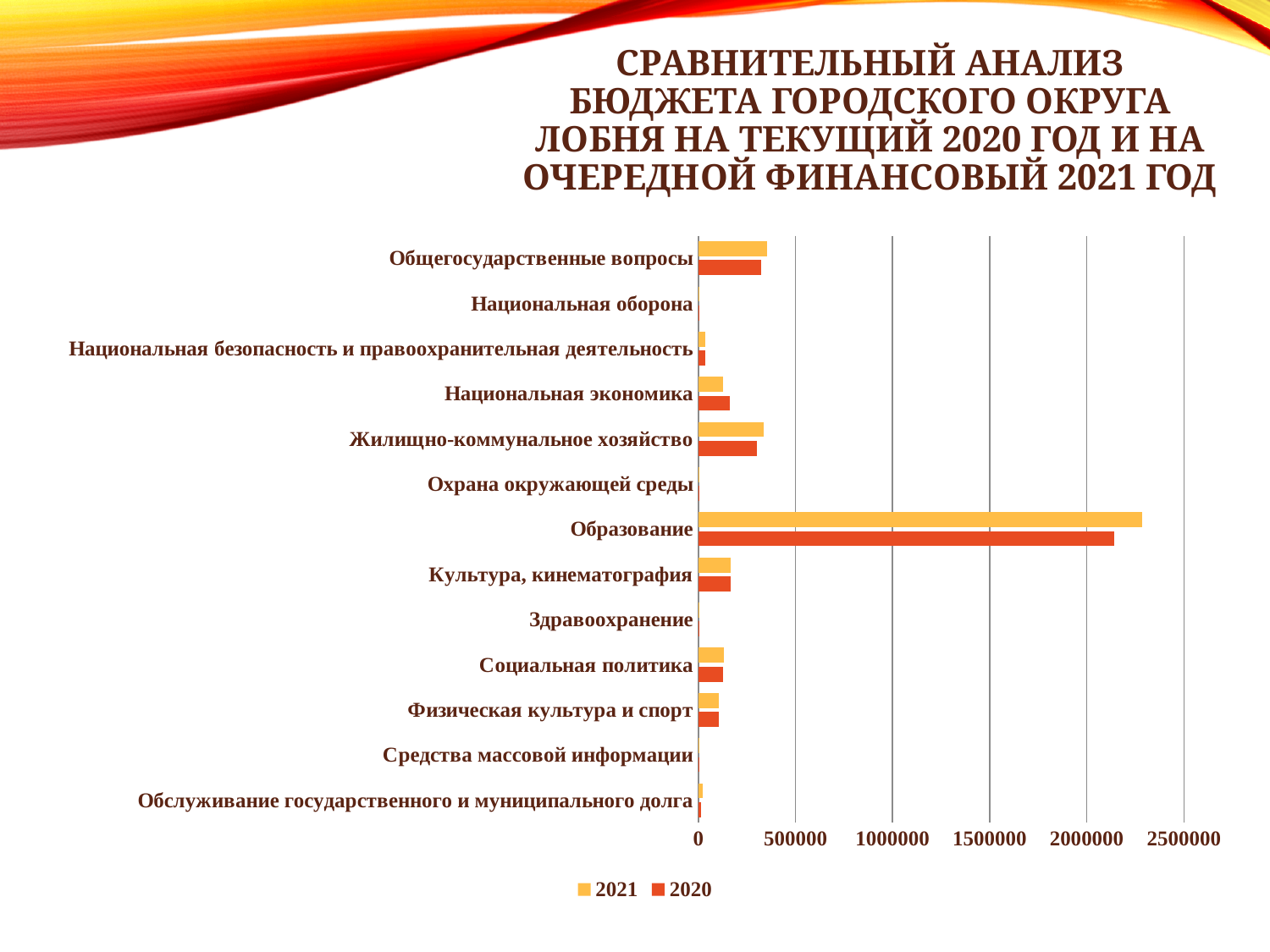
Which two series are listed in the legend? 2021 and 2020 For Образование, which series has the larger value, 2021 or 2020? 2021 Which category has the highest value for 2021? Образование What kind of chart is shown on the slide? bar chart For Национальная экономика, which series has the larger value, 2021 or 2020? 2020 Which category has the highest value for 2020? Образование How many series does the legend list? 2 Is the 2021 value for Образование greater or less than 2000000? greater Is the 2020 value for Образование greater or less than 2500000? less Which colour represents the 2020 series in the chart? red-orange Is the 2021 value for Общегосударственные вопросы greater or less than 500000? less How many categories are shown on the vertical axis of the chart? 13